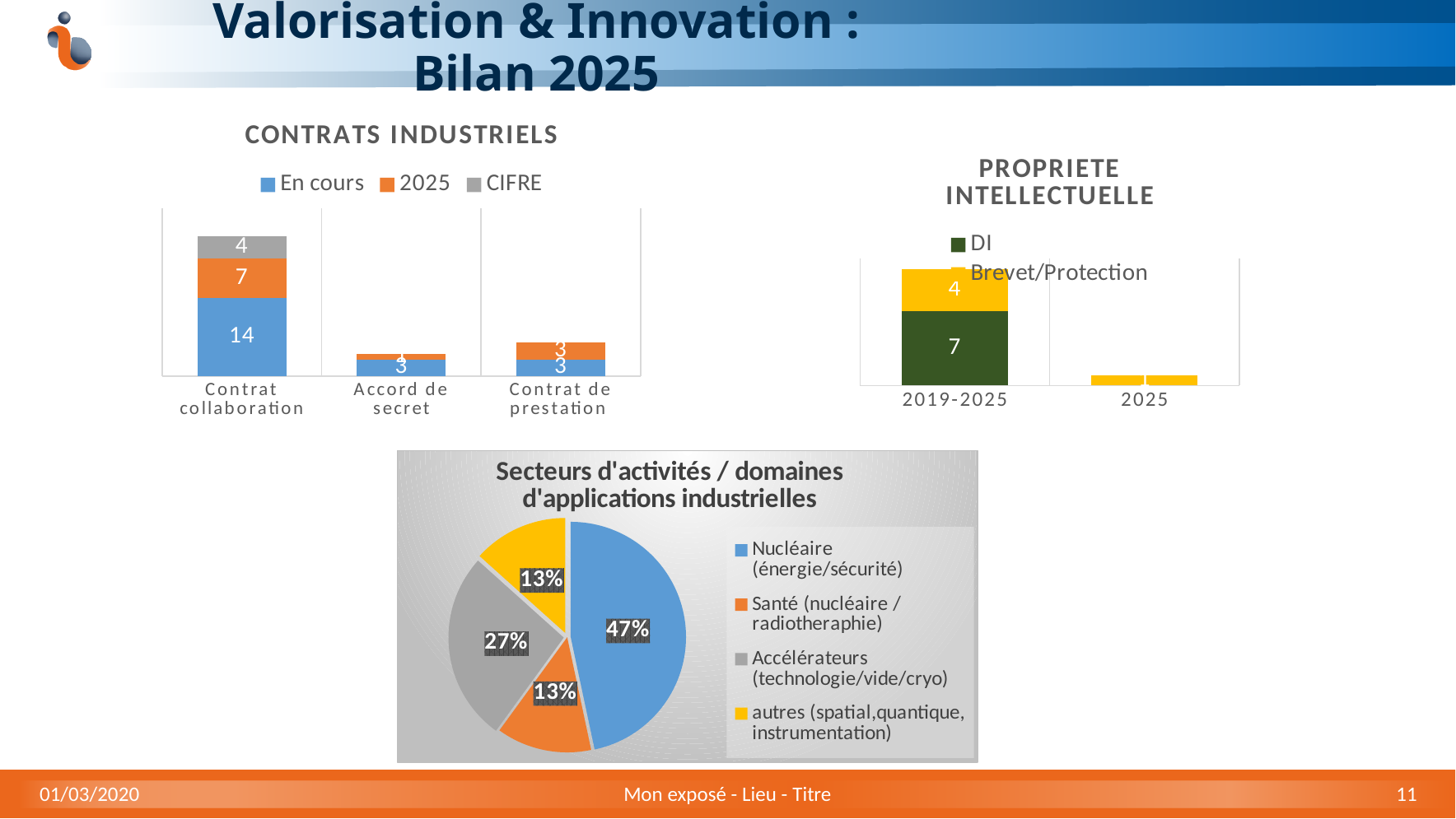
What kind of chart is 'Secteurs d'activités / domaines d'applications industrielles'? pie chart In the CONTRATS INDUSTRIELS chart, what is the total of the stacked bar for Contrat collaboration? 25 In the CONTRATS INDUSTRIELS chart, what is the 2025 value for Contrat de prestation? 3 In the CONTRATS INDUSTRIELS chart, how many series does the legend list? 3 In the PROPRIETE INTELLECTUELLE chart, which is larger for 2019-2025: DI or Brevet/Protection? DI In the pie chart 'Secteurs d'activités / domaines d'applications industrielles', what is the difference between the Accélérateurs share and the Santé share? 14% In the PROPRIETE INTELLECTUELLE chart, what is the DI value for 2019-2025? 7 In the CONTRATS INDUSTRIELS chart, what is the CIFRE value for Contrat collaboration? 4 In the CONTRATS INDUSTRIELS chart, which category has the highest total? Contrat collaboration In the CONTRATS INDUSTRIELS chart, what is the 'En cours' value for Contrat collaboration? 14 In the pie chart 'Secteurs d'activités / domaines d'applications industrielles', what share does Nucléaire (énergie/sécurité) have? 47% In the PROPRIETE INTELLECTUELLE chart, what is the total of the stacked bar for 2019-2025? 11